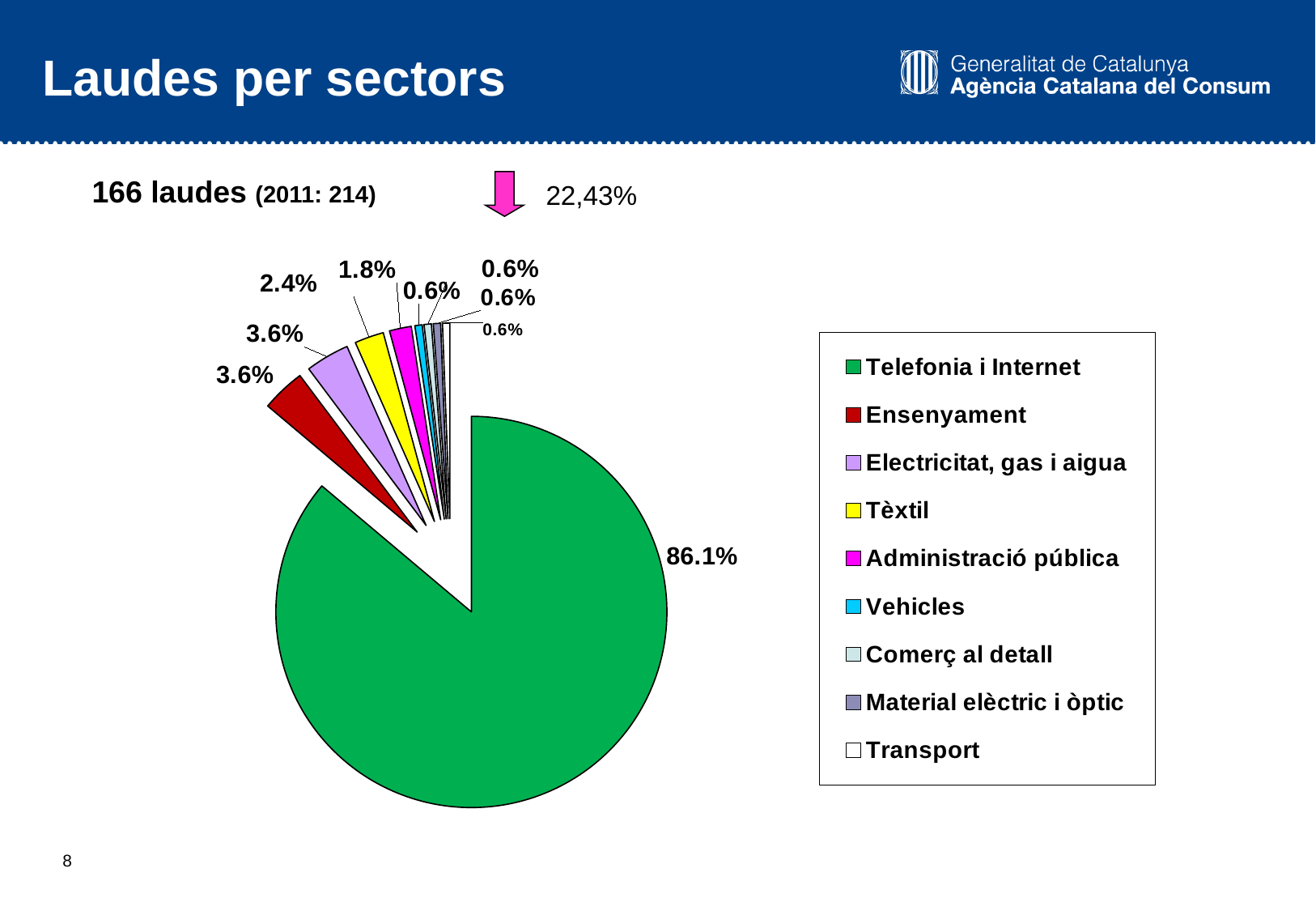
What is the value shown for Vehicles? 0.6% Which sector has the largest slice of the pie? Telefonia i Internet How many sectors are listed in the legend of the pie chart? 9 What colour is the slice for Telefonia i Internet? green What is the value shown for Tèxtil? 2.4% What is the difference in percentage points between Telefonia i Internet and Ensenyament? 82.5 What is the title of the slide containing the pie chart? Laudes per sectors What share of the pie does Telefonia i Internet represent? 86.1% What type of chart is shown on the slide? pie chart What is the value shown for Ensenyament? 3.6% Which is larger, the slice for Tèxtil or the slice for Administració pública? Tèxtil What is the value shown for Administració pública? 1.8%